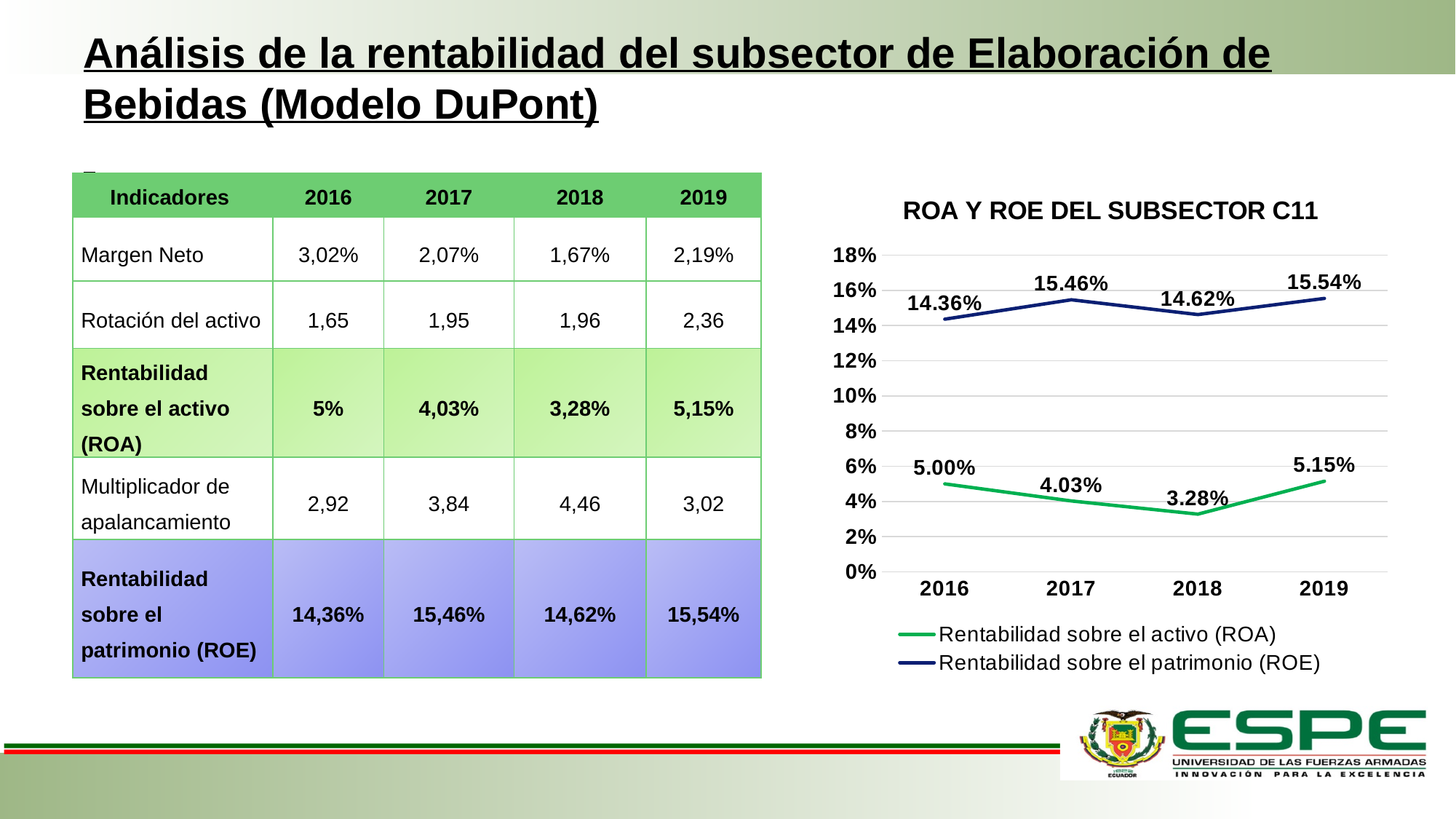
What is the ROE value for 2017 in the chart? 15.46% In which year is ROA lowest in the chart? 2018 What is the title of the chart? ROA Y ROE DEL SUBSECTOR C11 Is the ROE value for 2018 greater or less than 14%? greater In which year is ROE highest in the chart? 2019 How many years are shown on the x axis of the chart? 4 What kind of chart is shown on the slide? line chart What is the ROA value for 2019 in the chart? 5.15% Which is larger in the chart: ROA in 2016 or ROA in 2017? ROA in 2016 How many series does the chart legend list? 2 What is the difference between ROE and ROA in 2016 in the chart? 9.36% What is the ROA value for 2018 in the chart? 3.28%